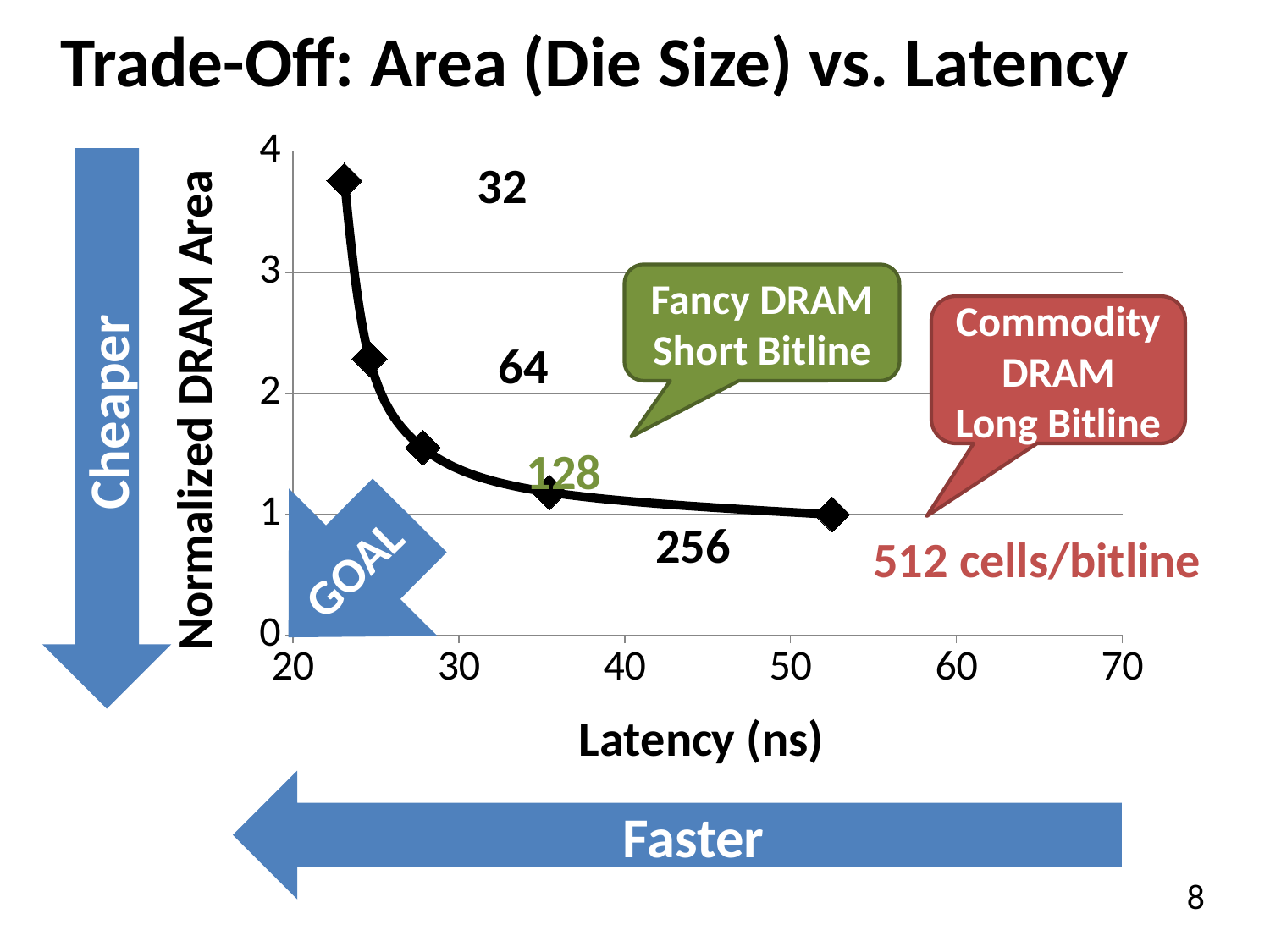
What kind of chart is shown on the slide? Line chart with markers (scatter) What is the label of the y axis? Normalized DRAM Area As latency increases along the x axis, does the normalized DRAM area rise or fall? fall Which cells/bitline configuration has the highest normalized DRAM area? 32 What is the normalized DRAM area for 512 cells/bitline? 1 Is the latency for the 512 cells/bitline point greater or less than 50 ns? greater What is the label of the x axis? Latency (ns) Which has a larger normalized DRAM area, the 64 or the 128 cells/bitline point? 64 How many data points are plotted on the curve? 5 Which cells/bitline configuration has the lowest normalized DRAM area? 512 cells/bitline Is the normalized DRAM area for the 64 cells/bitline point greater or less than 2? greater Is the normalized DRAM area for the 32 cells/bitline point greater or less than 3? greater